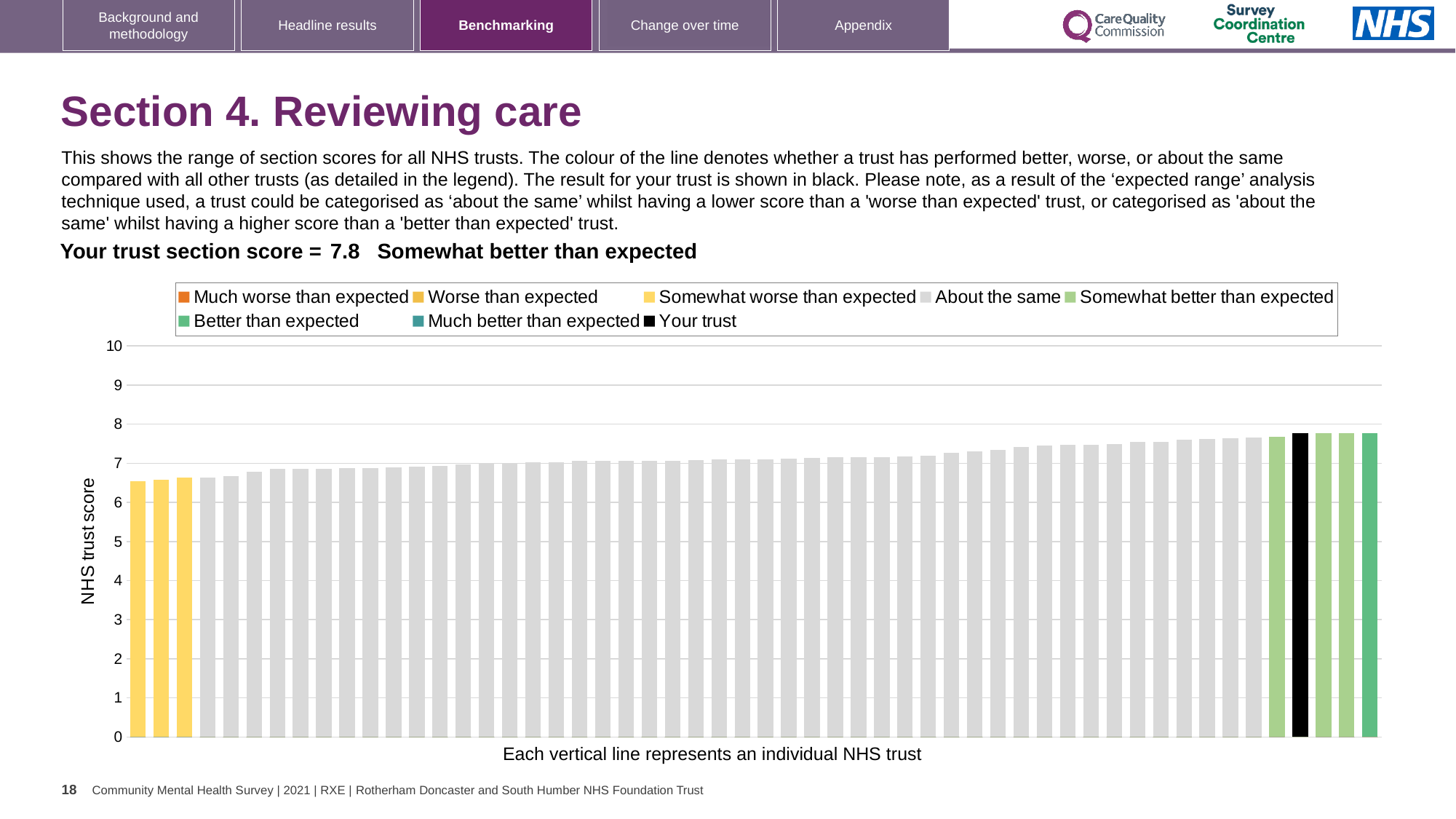
Is the value of the black 'Your trust' bar greater or less than 7? greater How many bars are coloured light green ('Somewhat better than expected') in the chart? 3 How many entries does the chart legend list? 8 Which category is your trust placed in according to the text above the chart? Somewhat better than expected Is the value of the leftmost bar greater or less than 7? less What is the section score for your trust shown on the slide? 7.8 Is the value of the rightmost bar greater or less than 8? less What kind of chart is shown on the slide? bar chart What is the label on the vertical axis of the chart? NHS trust score Which is taller: the black 'Your trust' bar or the leftmost yellow bar? the black 'Your trust' bar Do the bar heights rise or fall from left to right across the chart? rise